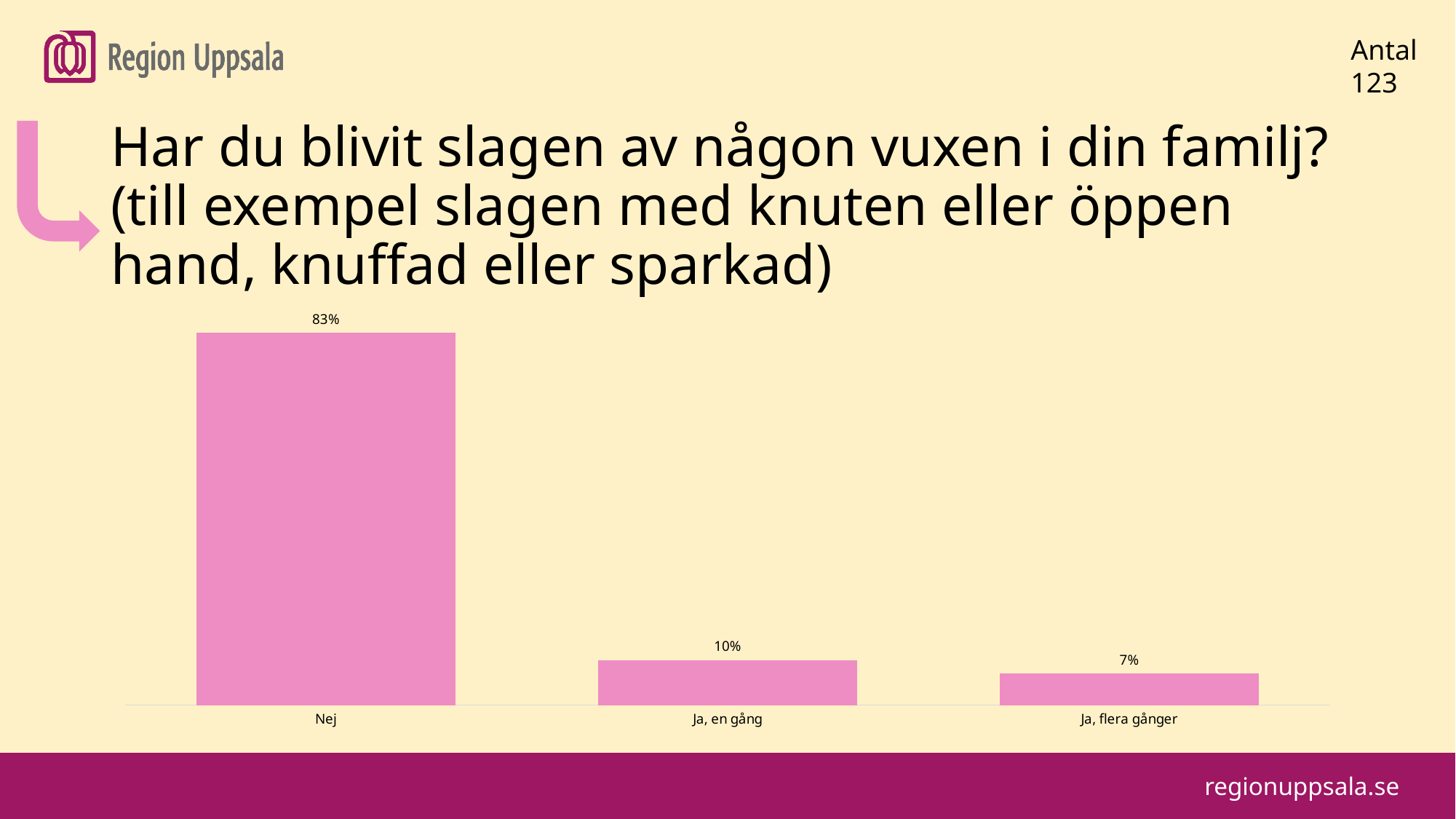
Which category has the lowest value? Ja, flera gånger What is the difference between the values for "Nej" and "Ja, en gång"? 73% What is the difference between the values for "Ja, en gång" and "Ja, flera gånger"? 3% Which is larger, the value for "Ja, en gång" or "Ja, flera gånger"? Ja, en gång What is the value for "Ja, en gång"? 10% What is the number of respondents (Antal) shown on the slide? 123 How many categories are shown in the chart? 3 What kind of chart is shown on the slide? Bar chart Do the values rise or fall from left to right across the categories? Fall Which category has the highest value? Nej What is the value for "Nej"? 83% What is the value for "Ja, flera gånger"? 7%